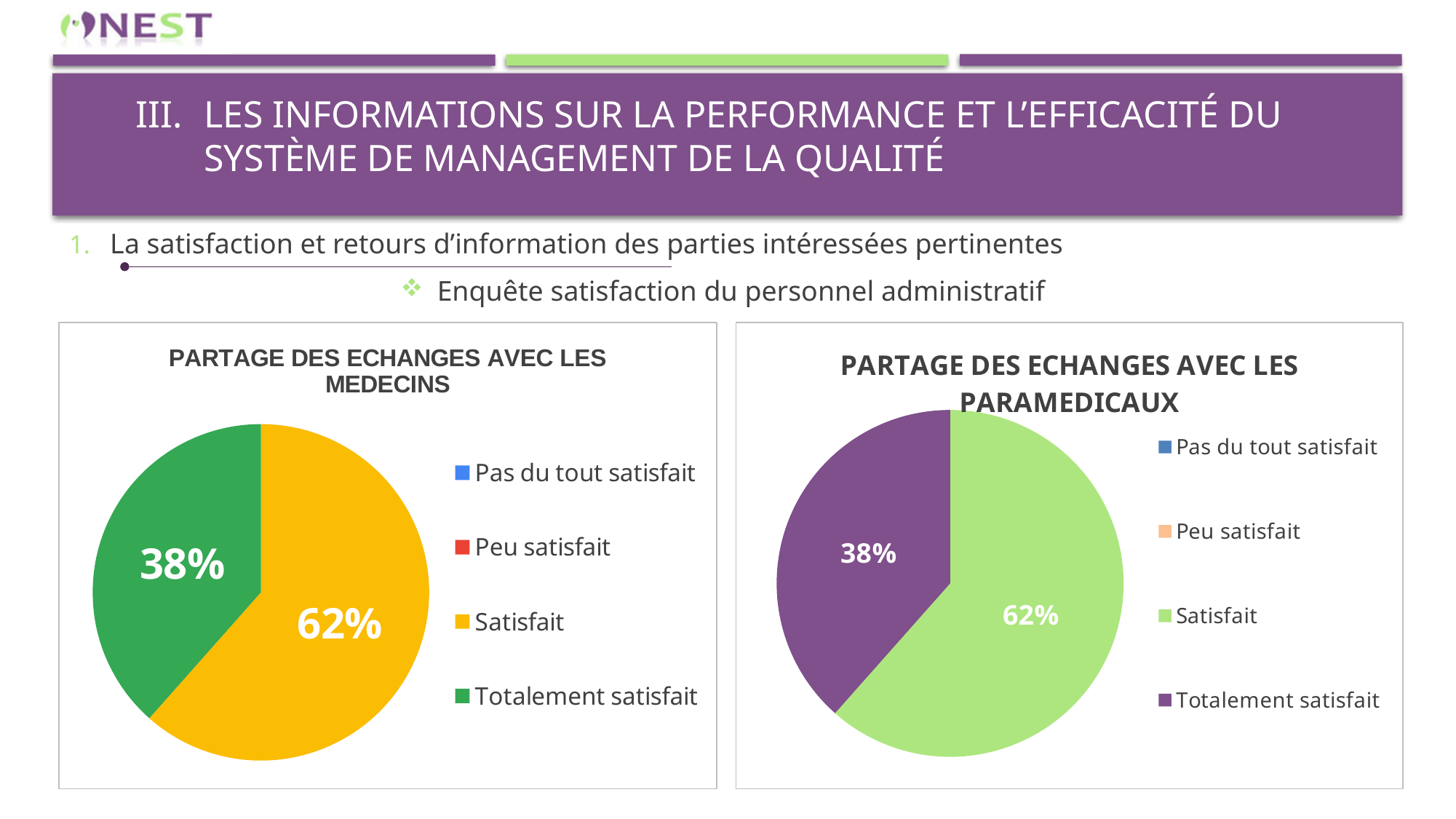
In the chart titled 'PARTAGE DES ECHANGES AVEC LES PARAMEDICAUX', which category has the largest slice? Satisfait In the chart titled 'PARTAGE DES ECHANGES AVEC LES MEDECINS', what share is labelled for 'Satisfait'? 62% In the chart titled 'PARTAGE DES ECHANGES AVEC LES MEDECINS', what colour is the 'Satisfait' slice? Yellow In the chart titled 'PARTAGE DES ECHANGES AVEC LES PARAMEDICAUX', what share is labelled for 'Totalement satisfait'? 38% In the chart titled 'PARTAGE DES ECHANGES AVEC LES MEDECINS', what is the difference between the 'Satisfait' and 'Totalement satisfait' shares? 24% In the chart titled 'PARTAGE DES ECHANGES AVEC LES PARAMEDICAUX', what share is labelled for 'Satisfait'? 62% In the chart titled 'PARTAGE DES ECHANGES AVEC LES PARAMEDICAUX', which is larger: 'Satisfait' or 'Totalement satisfait'? Satisfait How many entries does the legend list in the chart titled 'PARTAGE DES ECHANGES AVEC LES PARAMEDICAUX'? 4 In the chart titled 'PARTAGE DES ECHANGES AVEC LES MEDECINS', which category has the largest slice? Satisfait In the chart titled 'PARTAGE DES ECHANGES AVEC LES MEDECINS', what share is labelled for 'Totalement satisfait'? 38% In the chart titled 'PARTAGE DES ECHANGES AVEC LES PARAMEDICAUX', what colour is the 'Totalement satisfait' slice? Purple What type of chart is the one titled 'PARTAGE DES ECHANGES AVEC LES MEDECINS'? Pie chart